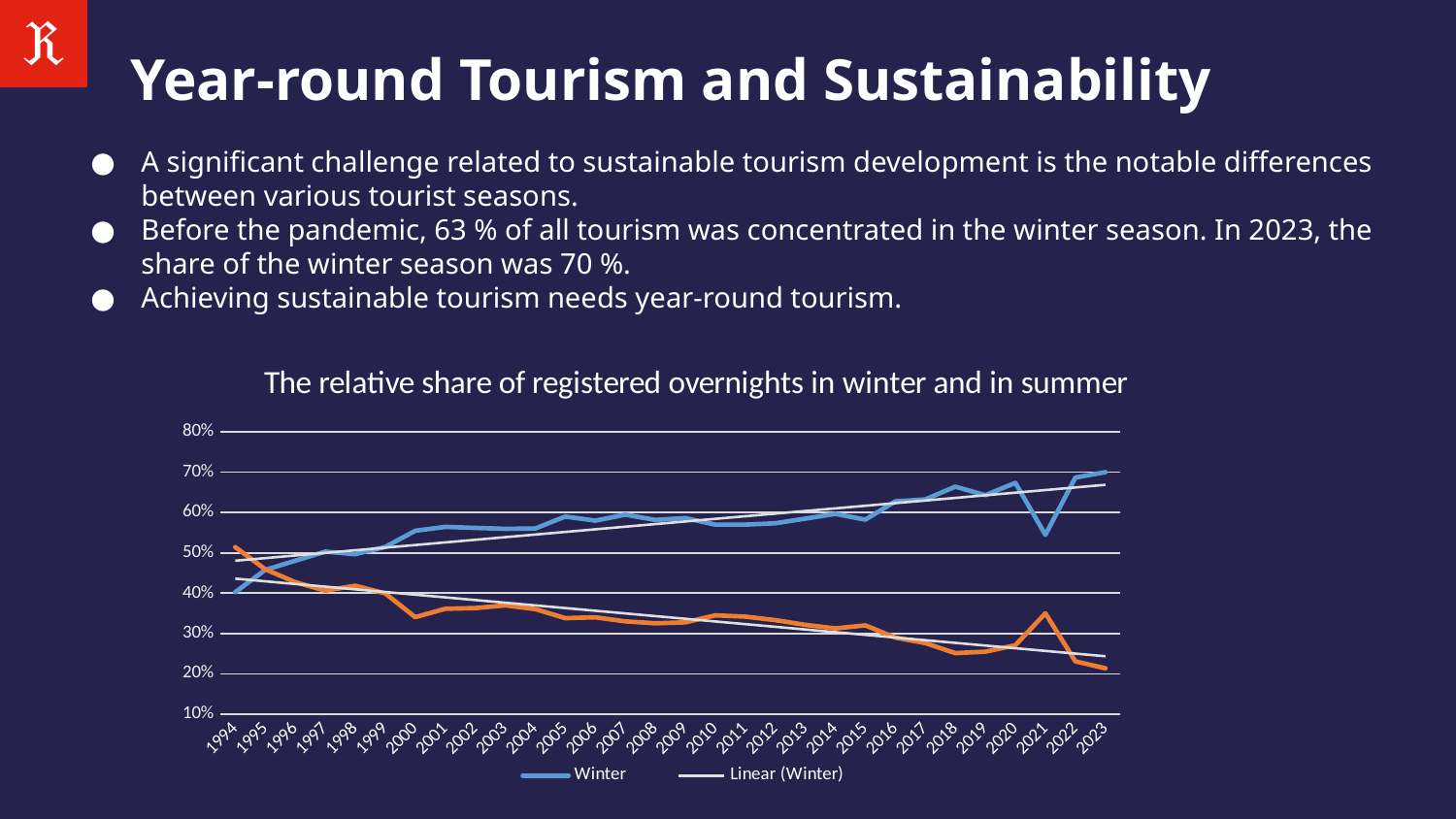
In which year is the Winter series at its lowest? 1994 Is the Winter value for 1994 greater or less than 50%? less Is the Winter value for 2021 greater or less than 50%? greater How many years are shown on the x axis of the chart? 30 What kind of chart is shown on the slide? line chart What is the title of the chart? The relative share of registered overnights in winter and in summer Does the Winter series rise or fall from 1994 to 2023? rise In 1994, which line is higher: the blue Winter line or the orange line? the orange line Is the Winter value for 2017 greater or less than 60%? greater How many series does the chart legend list? 2 In 2023, which line is higher: the blue Winter line or the orange line? the blue Winter line What are the two entries in the chart legend? Winter and Linear (Winter)